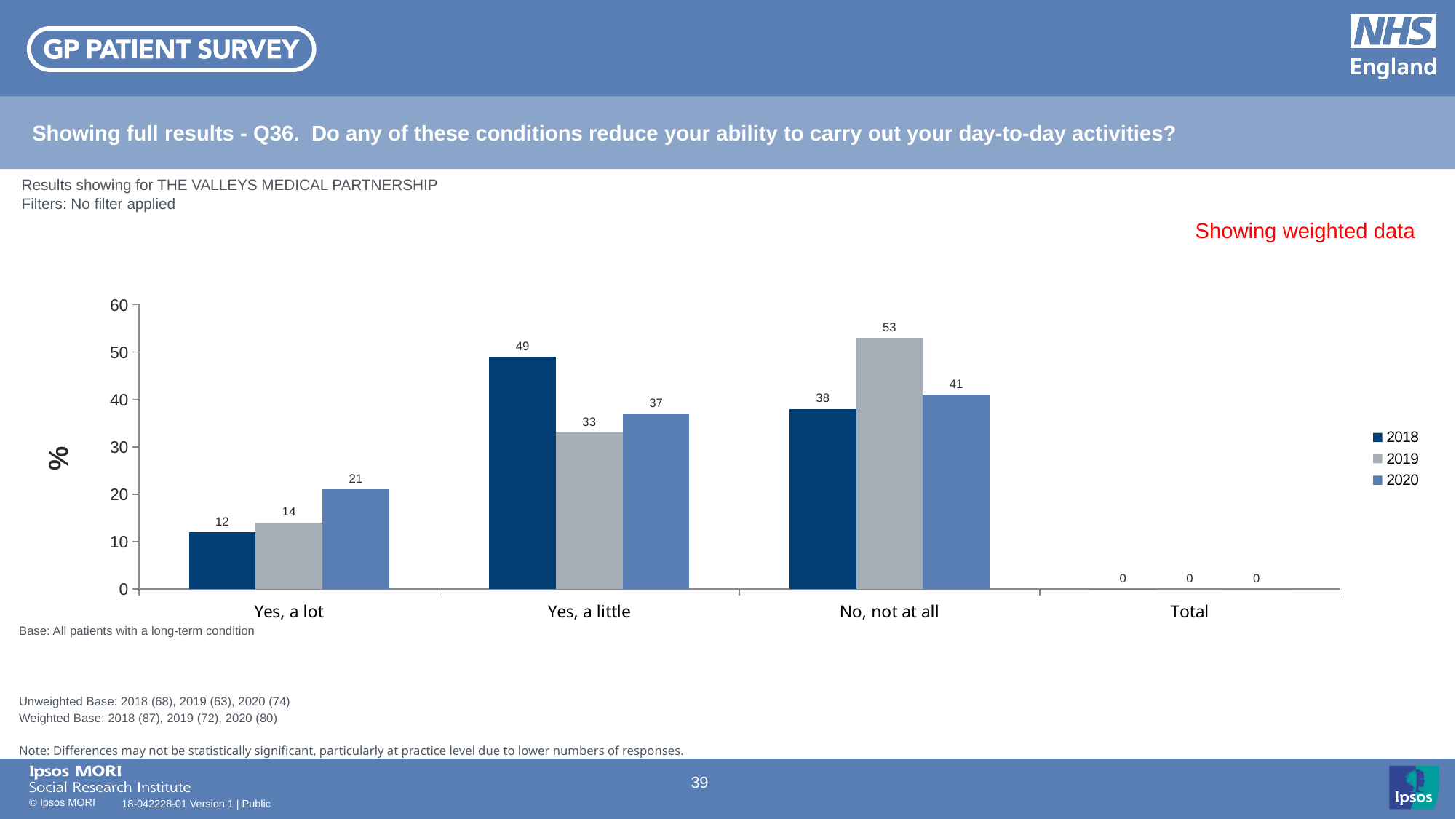
Do the values for 'Yes, a lot' rise or fall from 2018 to 2020? Rise Is the value for 'Yes, a little' in 2018 greater or less than 40? greater How many series does the legend list? 3 Which is larger for 'Yes, a little': the 2019 value or the 2020 value? 2020 What kind of chart is shown on the slide? Bar chart What is the difference between the 2019 and 2018 values for 'No, not at all'? 15 Which category has the lowest value for the 2018 series? Total What is the value for 'Yes, a lot' in 2020? 21 What is the value for 'No, not at all' in 2019? 53 What is the value for 'Yes, a little' in 2018? 49 Which category has the highest value for the 2020 series? No, not at all How many categories are shown on the x axis? 4